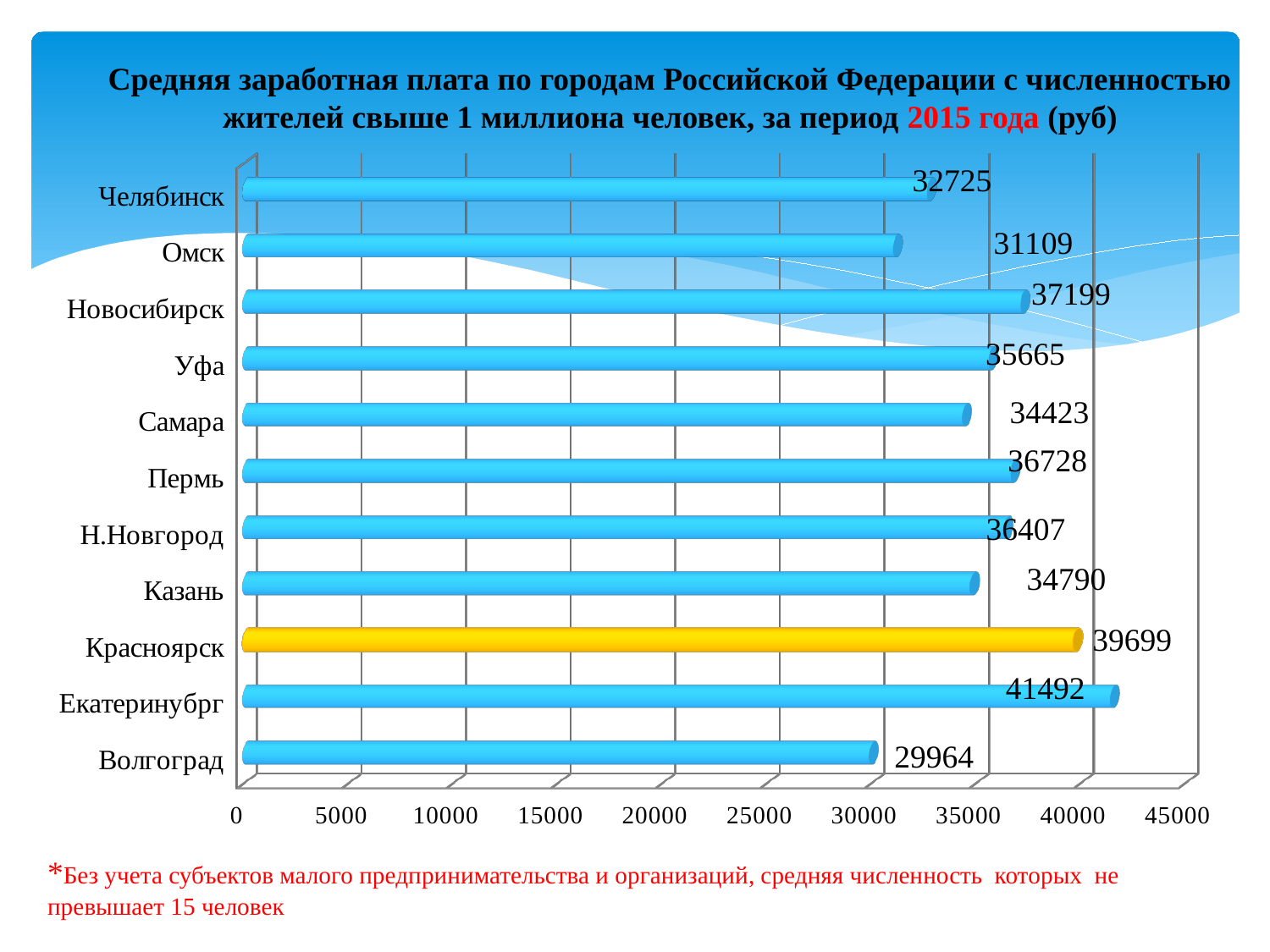
Is the value for Омск greater or less than 30000? greater How many cities are shown on the chart? 11 What is the difference between the values for Уфа and Казань? 875 What kind of chart is shown on the slide? bar chart What is the value shown for Новосибирск? 37199 Which city has the lowest average salary on the chart? Волгоград Which city's bar is coloured yellow instead of blue? Красноярск What is the difference between the values for Екатеринубрг and Красноярск? 1793 What is the value shown for Волгоград? 29964 Which has a larger value, Пермь or Самара? Пермь What is the average salary shown for Красноярск? 39699 Which city has the highest average salary on the chart? Екатеринубрг